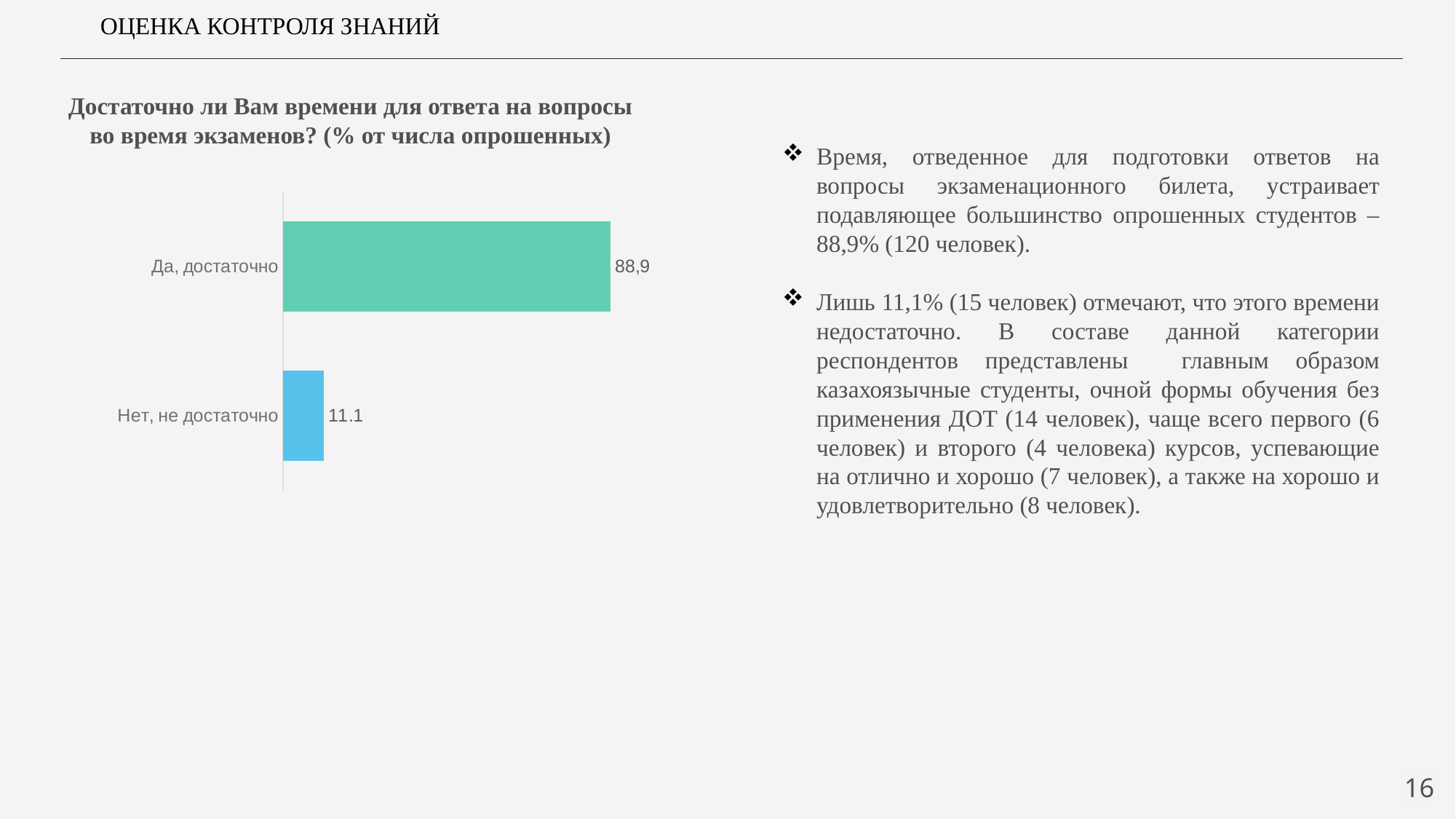
What is the value for "Да, достаточно"? 88,9 What is the value for "Нет, не достаточно"? 11.1 What type of chart is shown on the slide? bar chart What is the title of the chart? Достаточно ли Вам времени для ответа на вопросы во время экзаменов? (% от числа опрошенных) Which category has the lowest value? Нет, не достаточно What colour is the bar for "Нет, не достаточно"? blue Which is larger: the value for "Да, достаточно" or the value for "Нет, не достаточно"? Да, достаточно How many categories does the chart show? 2 Which category has the highest value? Да, достаточно